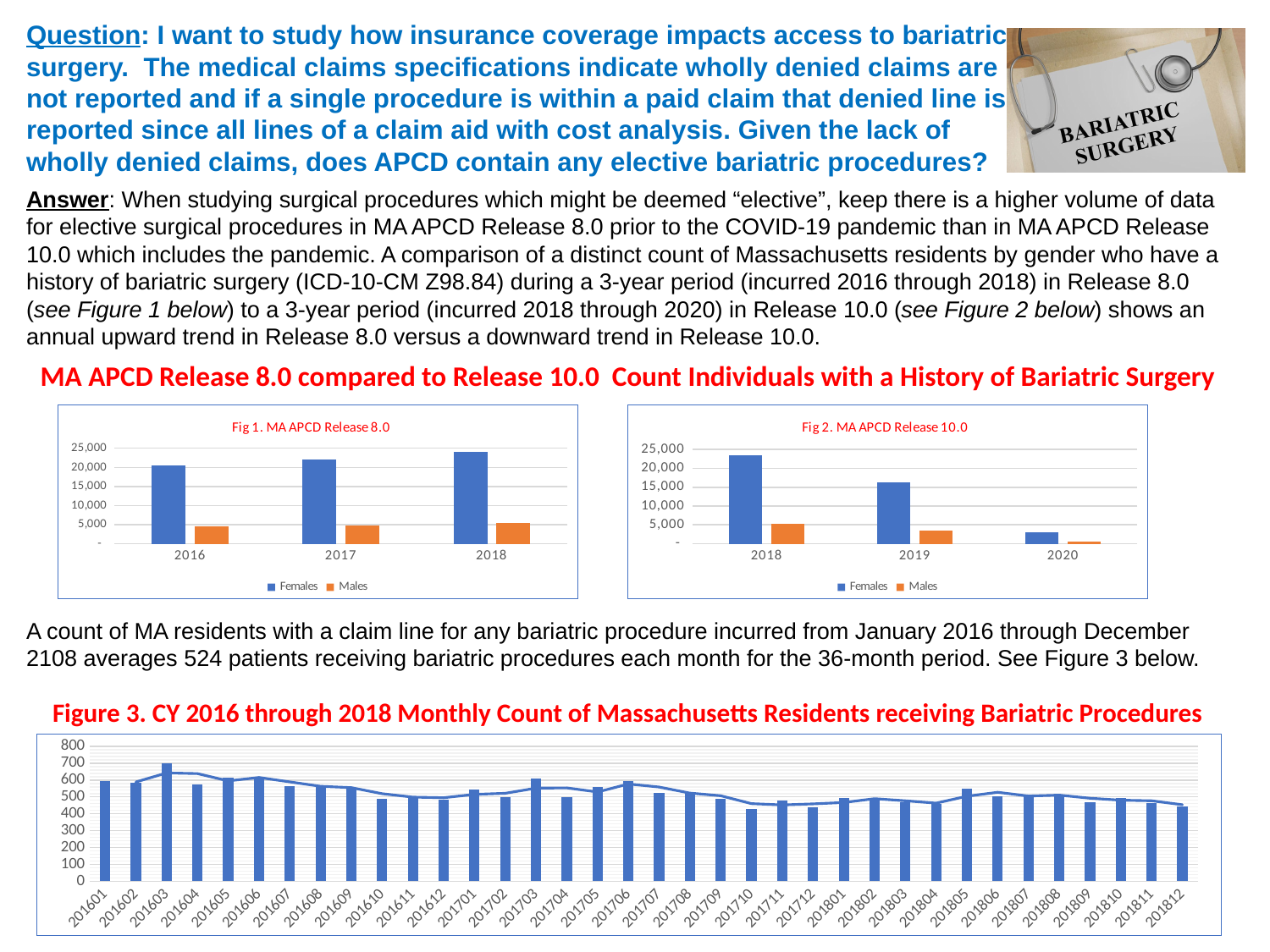
In Figure 3, which month has the highest count? 201603 In Fig 1. MA APCD Release 8.0, how many series does the legend list? 2 In Figure 3, is the value for 201710 greater or less than 500? less In Fig 1. MA APCD Release 8.0, do the Females values rise or fall from 2016 to 2018? rise In Fig 1. MA APCD Release 8.0, is the value for Females in 2016 greater or less than 15,000? greater In Fig 1. MA APCD Release 8.0, what kind of chart is shown? bar chart In Fig 2. MA APCD Release 10.0, do the Females values rise or fall from 2018 to 2020? fall In Fig 2. MA APCD Release 10.0, which is larger in 2018: Females or Males? Females In Fig 2. MA APCD Release 10.0, which year has the lowest value for Females? 2020 In Fig 2. MA APCD Release 10.0, is the value for Females in 2019 greater or less than 20,000? less In Figure 3, how many months are plotted along the x axis? 36 In Fig 1. MA APCD Release 8.0, which year has the highest value for Females? 2018